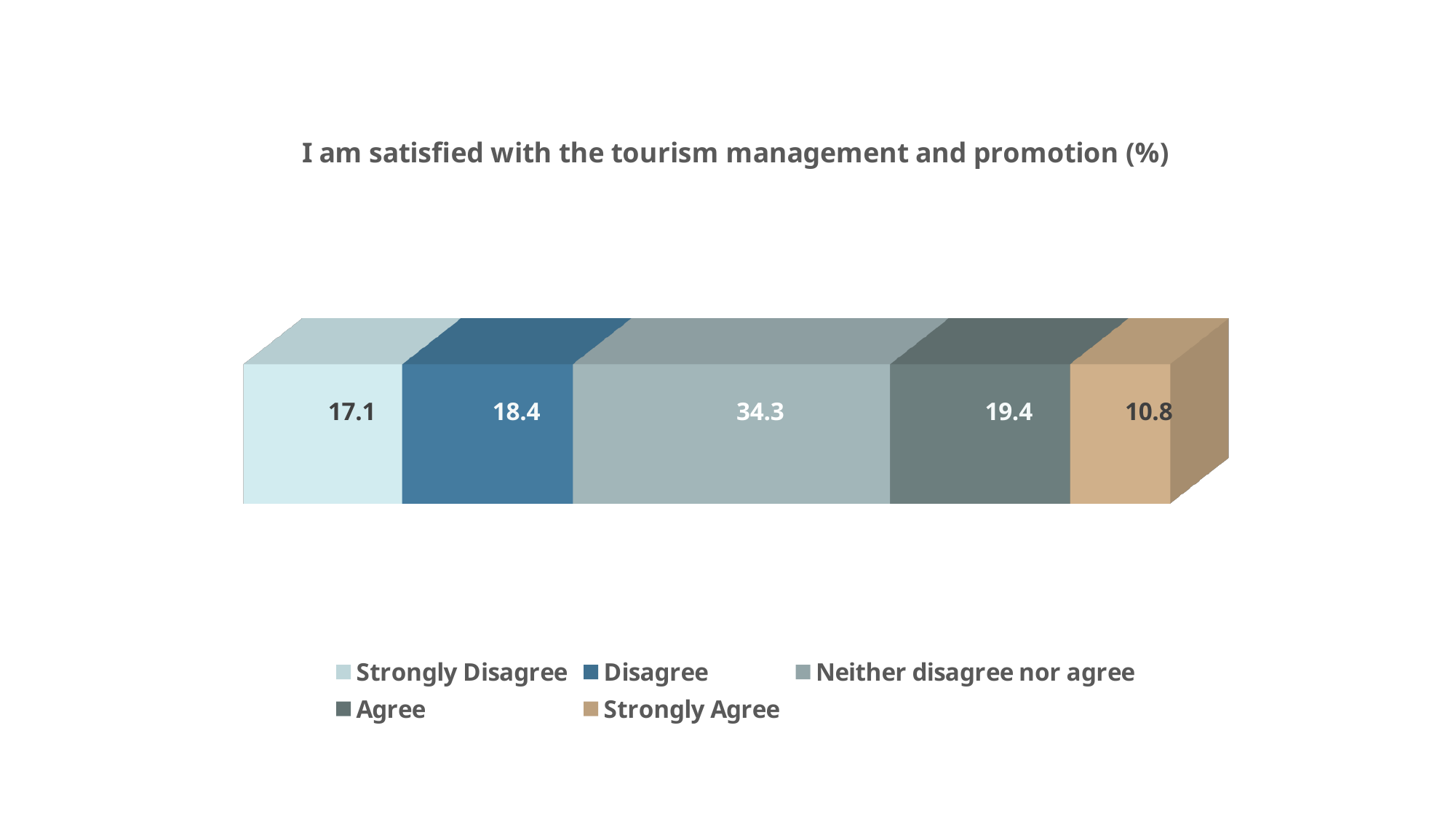
How many series does the legend list? 5 Which response category has the highest value? Neither disagree nor agree Which response category has the lowest value? Strongly Agree Which is larger, the value for Agree or the value for Disagree? Agree What is the value for Strongly Agree? 10.8 What is the value for Strongly Disagree? 17.1 What is the difference between the values for Neither disagree nor agree and Agree? 14.9 What is the value for Neither disagree nor agree? 34.3 What kind of chart is shown on the slide? Stacked bar chart What is the value for Disagree? 18.4 What is the value for Agree? 19.4 What is the title of the chart? I am satisfied with the tourism management and promotion (%)